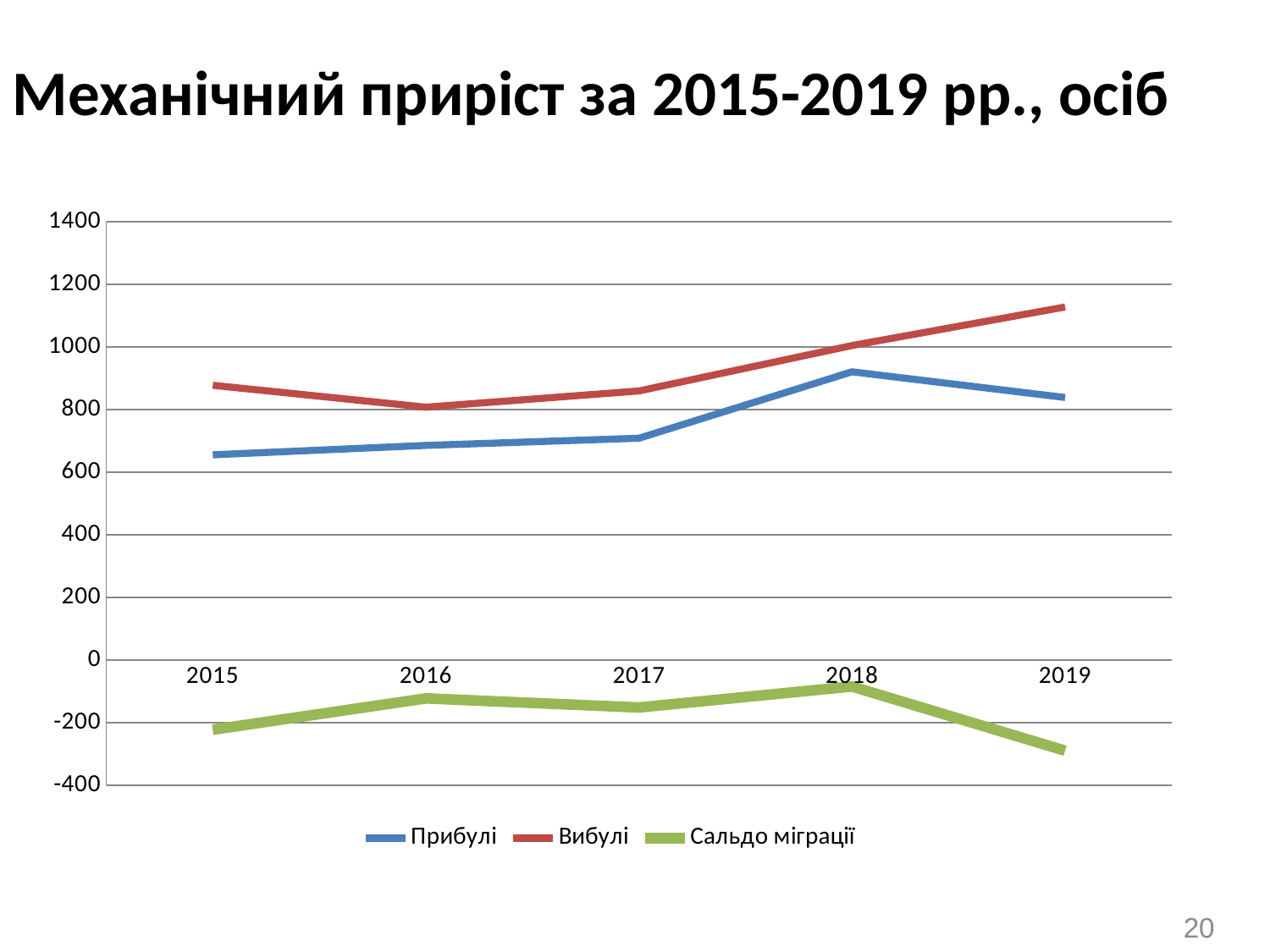
How many series does the legend list? 3 In which year is the value for Вибулі lowest? 2016 In which year is the value for Сальдо міграції lowest? 2019 Is the value for Вибулі in 2019 greater or less than 1000? greater Is the value for Сальдо міграції in 2019 greater or less than -200? less Which series has the larger value in 2018, Прибулі or Вибулі? Вибулі In which year is the value for Вибулі highest? 2019 What kind of chart is shown on the slide? line chart Is the value for Прибулі in 2015 greater or less than 800? less How many years are plotted along the x axis? 5 Does the value for Вибулі rise or fall from 2017 to 2019? rise In which year is the value for Прибулі highest? 2018